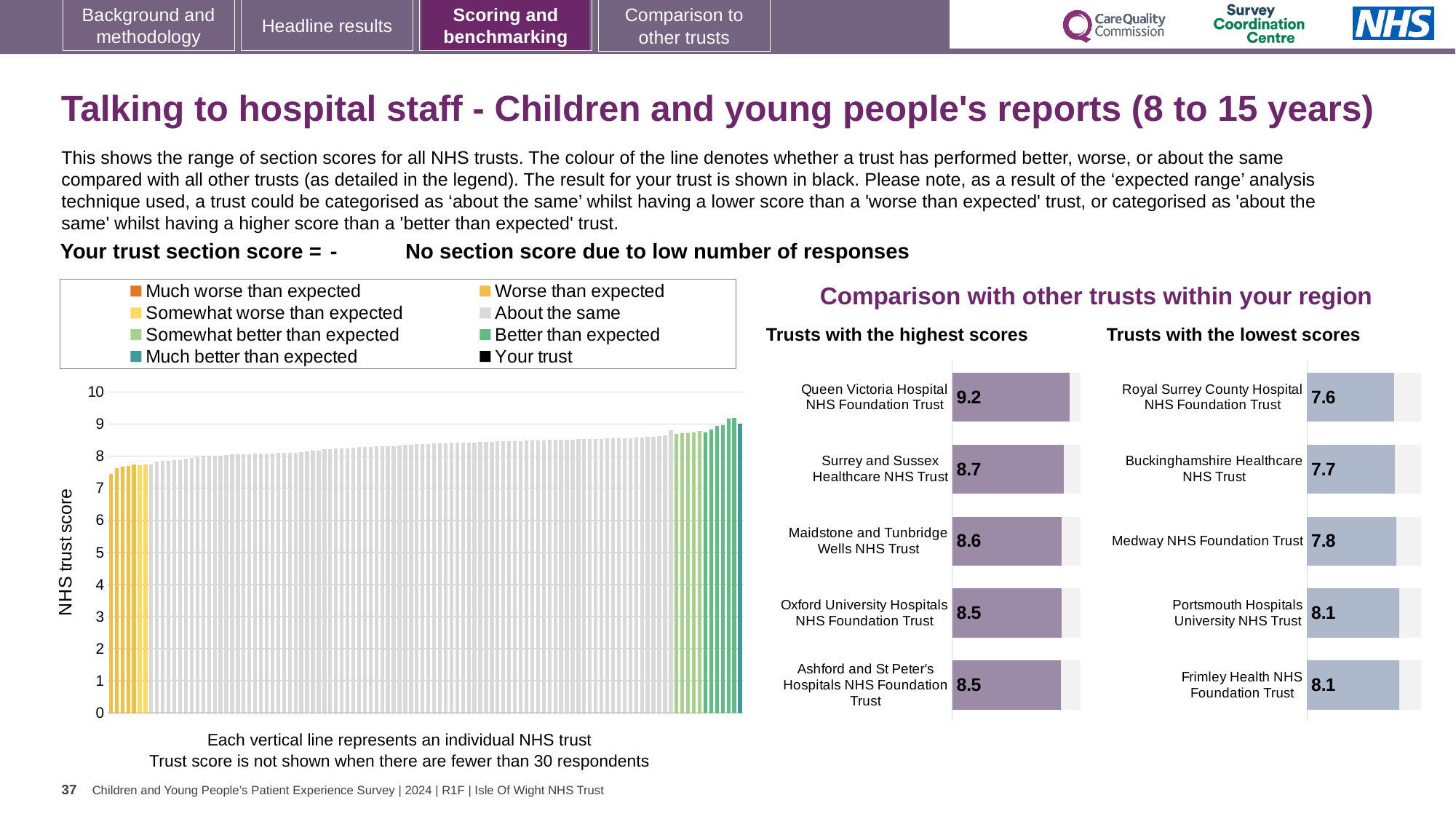
In the large chart on the left, do the trust scores rise or fall from left to right? Rise In the 'Trusts with the highest scores' chart, which trust has the highest score? Queen Victoria Hospital NHS Foundation Trust In the 'Trusts with the highest scores' chart, what is the score for Maidstone and Tunbridge Wells NHS Trust? 8.6 In the 'Trusts with the lowest scores' chart, what is the score for Medway NHS Foundation Trust? 7.8 How many trusts are shown in the 'Trusts with the lowest scores' chart? 5 In the 'Trusts with the lowest scores' chart, which trust has the lowest score? Royal Surrey County Hospital NHS Foundation Trust In the 'Trusts with the highest scores' chart, what is the score for Queen Victoria Hospital NHS Foundation Trust? 9.2 How many entries does the legend above the large chart on the left list? 8 In the large chart on the left, is the value of the leftmost bar greater or less than 7? greater In the 'Trusts with the highest scores' chart, what is the difference between the scores of Queen Victoria Hospital NHS Foundation Trust and Surrey and Sussex Healthcare NHS Trust? 0.5 In the 'Trusts with the lowest scores' chart, which has the larger score: Buckinghamshire Healthcare NHS Trust or Portsmouth Hospitals University NHS Trust? Portsmouth Hospitals University NHS Trust What kind of chart is the large chart on the left showing NHS trust scores? Bar chart